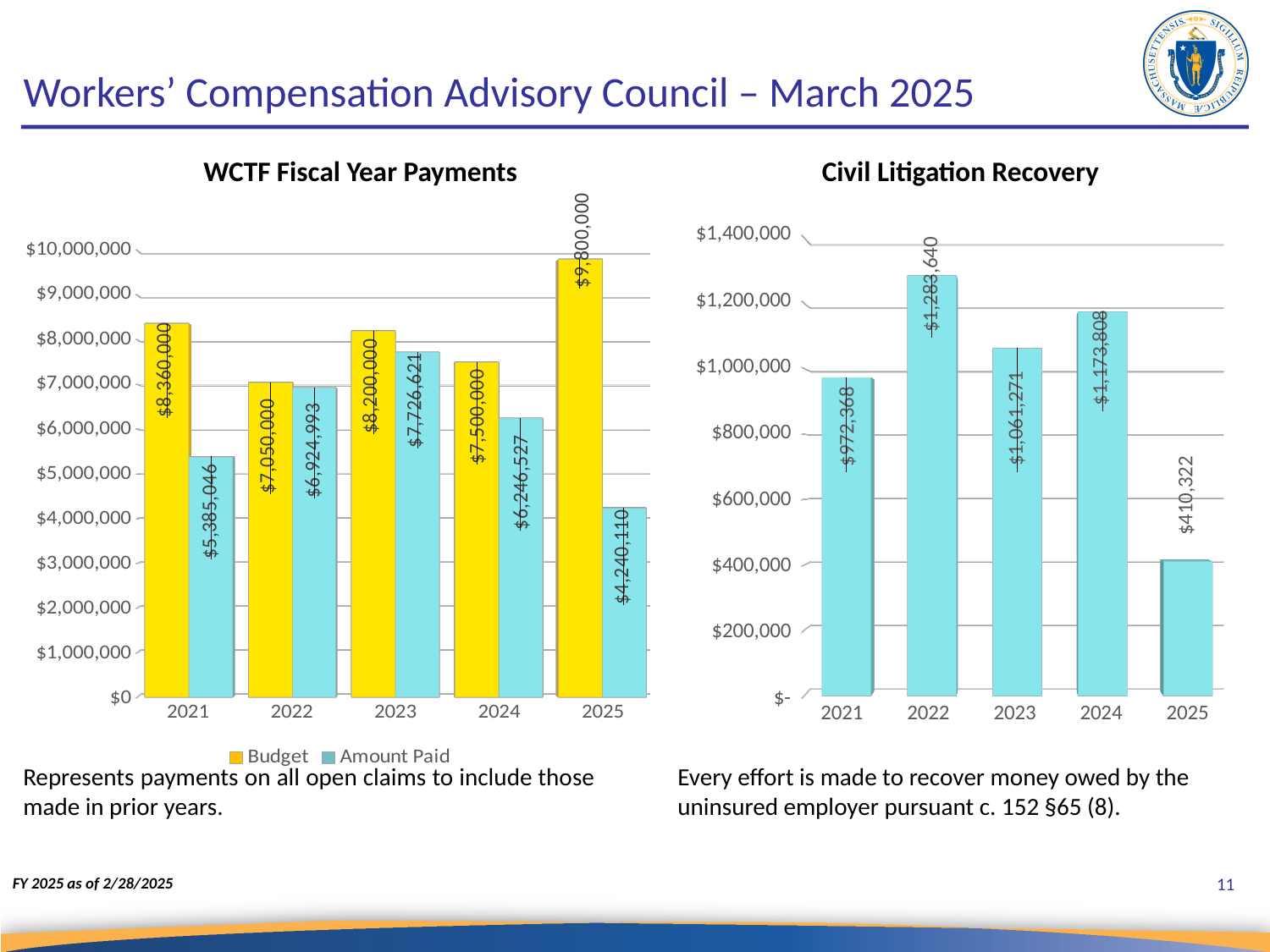
In the WCTF Fiscal Year Payments chart, which year has the lowest Amount Paid? 2025 What type of chart is the Civil Litigation Recovery chart? Bar chart In the WCTF Fiscal Year Payments chart, what is the difference between the Budget and the Amount Paid in 2021? $2,974,954 How many series does the legend of the WCTF Fiscal Year Payments chart list? 2 In the WCTF Fiscal Year Payments chart, is the Budget for 2025 greater or less than $9,000,000? greater In the WCTF Fiscal Year Payments chart, which colour represents the Budget series? Yellow In the Civil Litigation Recovery chart, is the 2021 value larger or smaller than the 2023 value? Smaller In the Civil Litigation Recovery chart, what was the recovery in 2024? $1,173,808 In the WCTF Fiscal Year Payments chart, what was the Budget for 2022? $7,050,000 In the Civil Litigation Recovery chart, which year has the highest value? 2022 In the Civil Litigation Recovery chart, what is the difference between the 2022 and 2025 values? $873,318 In the WCTF Fiscal Year Payments chart, what was the Amount Paid in 2023? $7,726,621